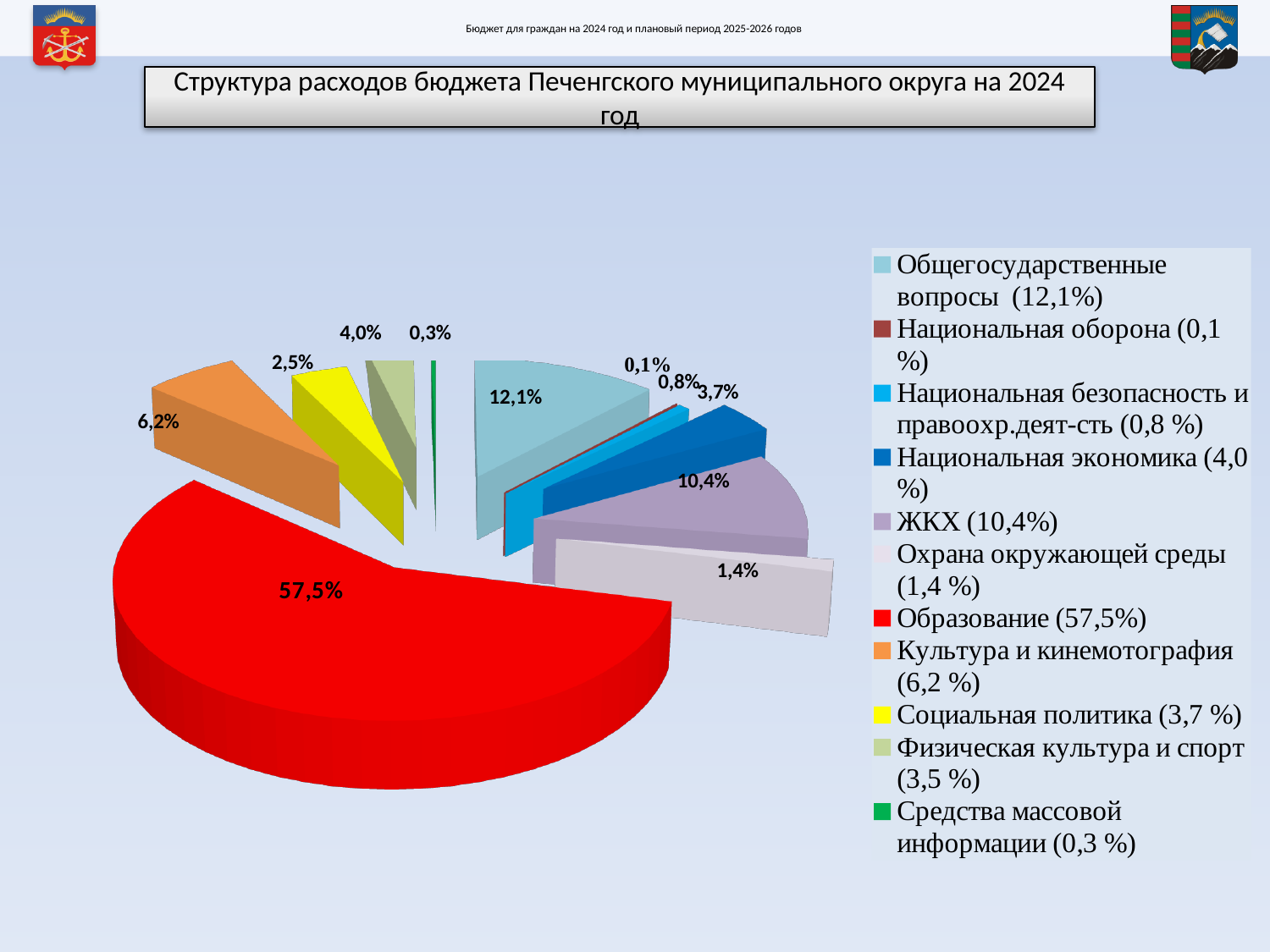
What is the difference between the share for Образование and the share for Общегосударственные вопросы? 45,4% What share is shown for ЖКХ? 10,4% Which is larger: the share for ЖКХ or the share for Общегосударственные вопросы? Общегосударственные вопросы What share is shown for Общегосударственные вопросы? 12,1% What share is shown for Культура и кинемотография? 6,2 % What share is shown for Охрана окружающей среды? 1,4 % What colour is the slice for Образование? red Which category has the smallest share according to the legend? Национальная оборона What share of the budget expenditure does Образование account for? 57,5% Which category has the largest share of the budget expenditure? Образование What kind of chart is shown on the slide? pie chart How many categories does the legend list? 11